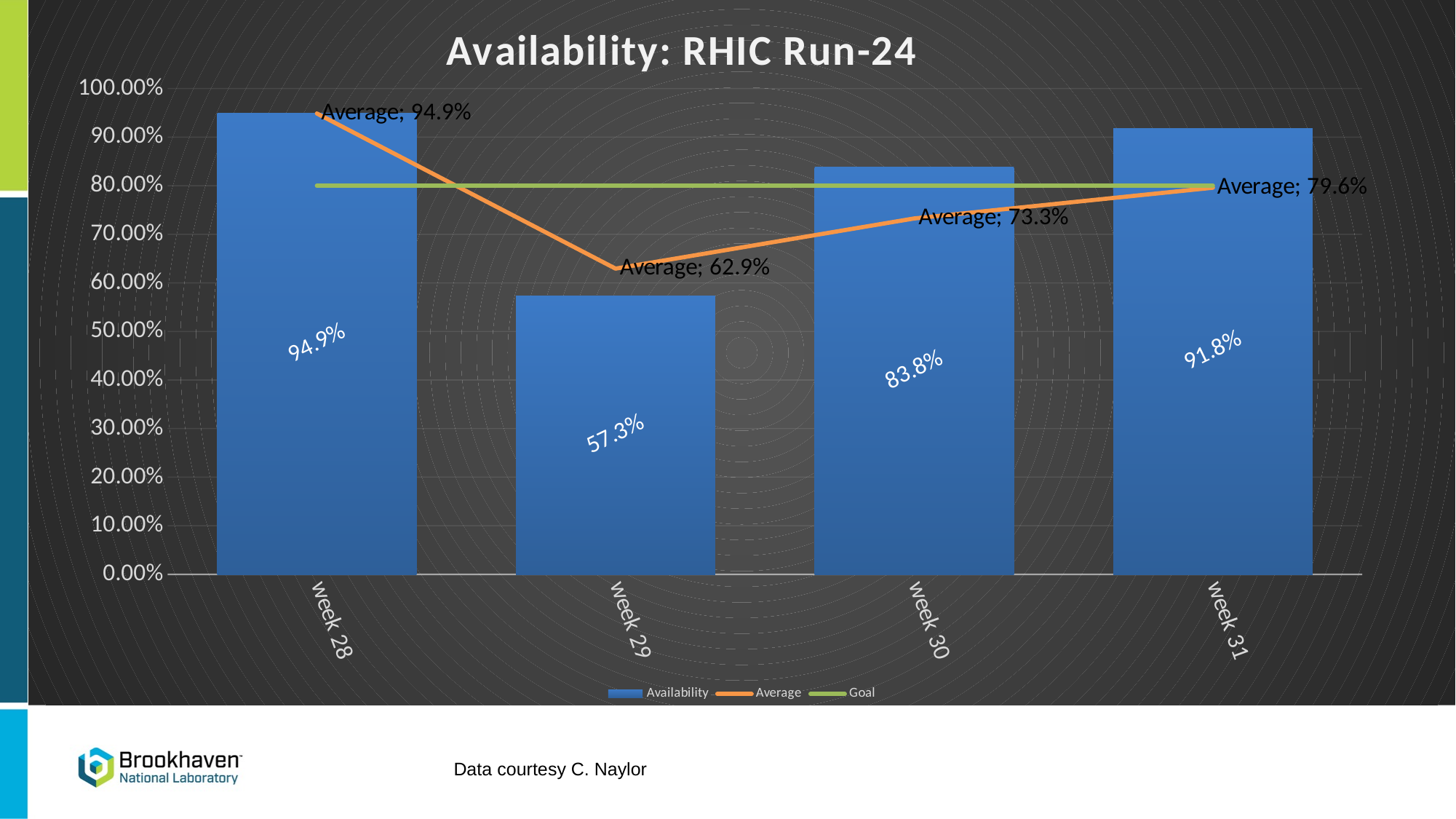
Which is larger, the Availability for week 30 or for week 31? week 31 Is the Goal line value greater or less than 90.00%? less What is the difference in Availability between week 28 and week 29? 37.6% How many series does the legend list? 3 What is the title of the chart? Availability: RHIC Run-24 How many weeks are shown on the x axis? 4 What is the Average value labelled at week 30? 73.3% What is the Availability value for week 31? 91.8% Which week has the highest Availability? week 28 What is the Availability value for week 29? 57.3% What is the Average value labelled at week 31? 79.6% Which week has the lowest Availability? week 29